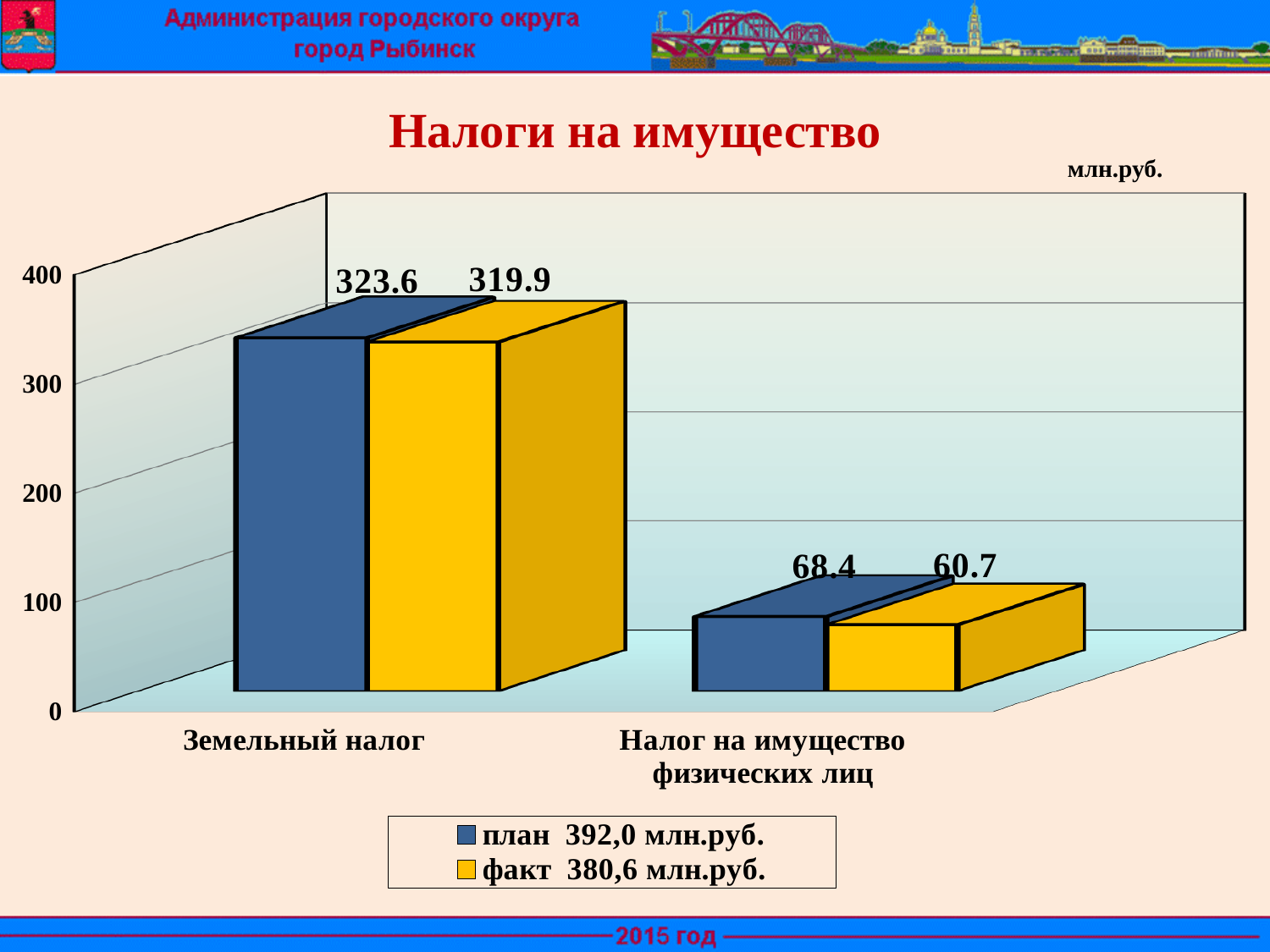
What type of chart is shown on the slide? bar chart What is the факт value for Налог на имущество физических лиц? 60.7 How many categories are shown on the x axis? 2 Which is larger for Земельный налог: план or факт? план Which category has the highest факт value? Земельный налог What is the difference between the план values for Земельный налог and Налог на имущество физических лиц? 255.2 What is the факт value for Земельный налог? 319.9 What is the difference between the план and факт values for Налог на имущество физических лиц? 7.7 What is the план value for Земельный налог? 323.6 What is the план value for Налог на имущество физических лиц? 68.4 Which category has the lowest план value? Налог на имущество физических лиц How many series does the legend list? 2